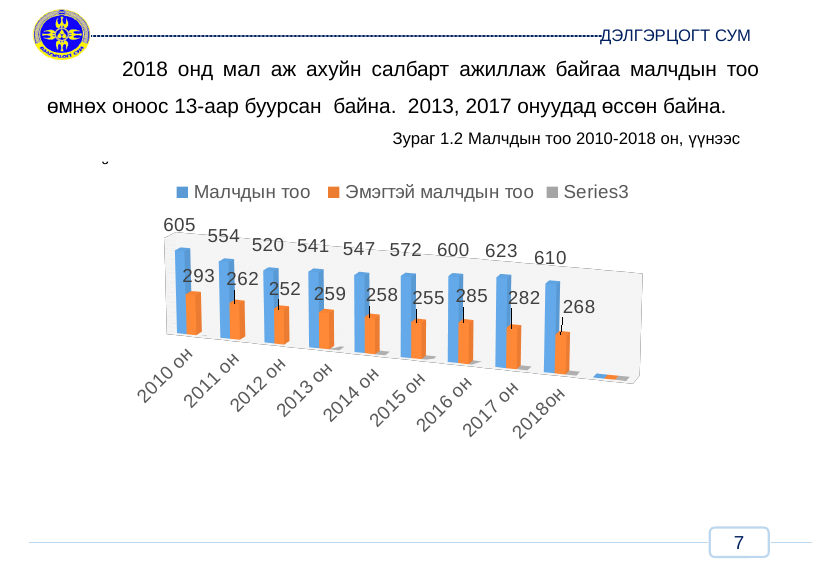
What is the value of Малчдын тоо for 2018он? 610 Which year has the highest value for Эмэгтэй малчдын тоо? 2010 он What kind of chart is shown on the slide? Bar chart Which is larger: Эмэгтэй малчдын тоо in 2011 он or in 2012 он? 2011 он What is the value of Малчдын тоо for 2010 он? 605 Which year has the lowest value for Малчдын тоо? 2012 он How many years are shown on the x axis? 9 What is the difference between Малчдын тоо in 2017 он and 2018он? 13 What is the difference between Малчдын тоо and Эмэгтэй малчдын тоо in 2015 он? 317 How many series does the legend list? 3 Which year has the highest value for Малчдын тоо? 2017 он What is the value of Эмэгтэй малчдын тоо for 2016 он? 285